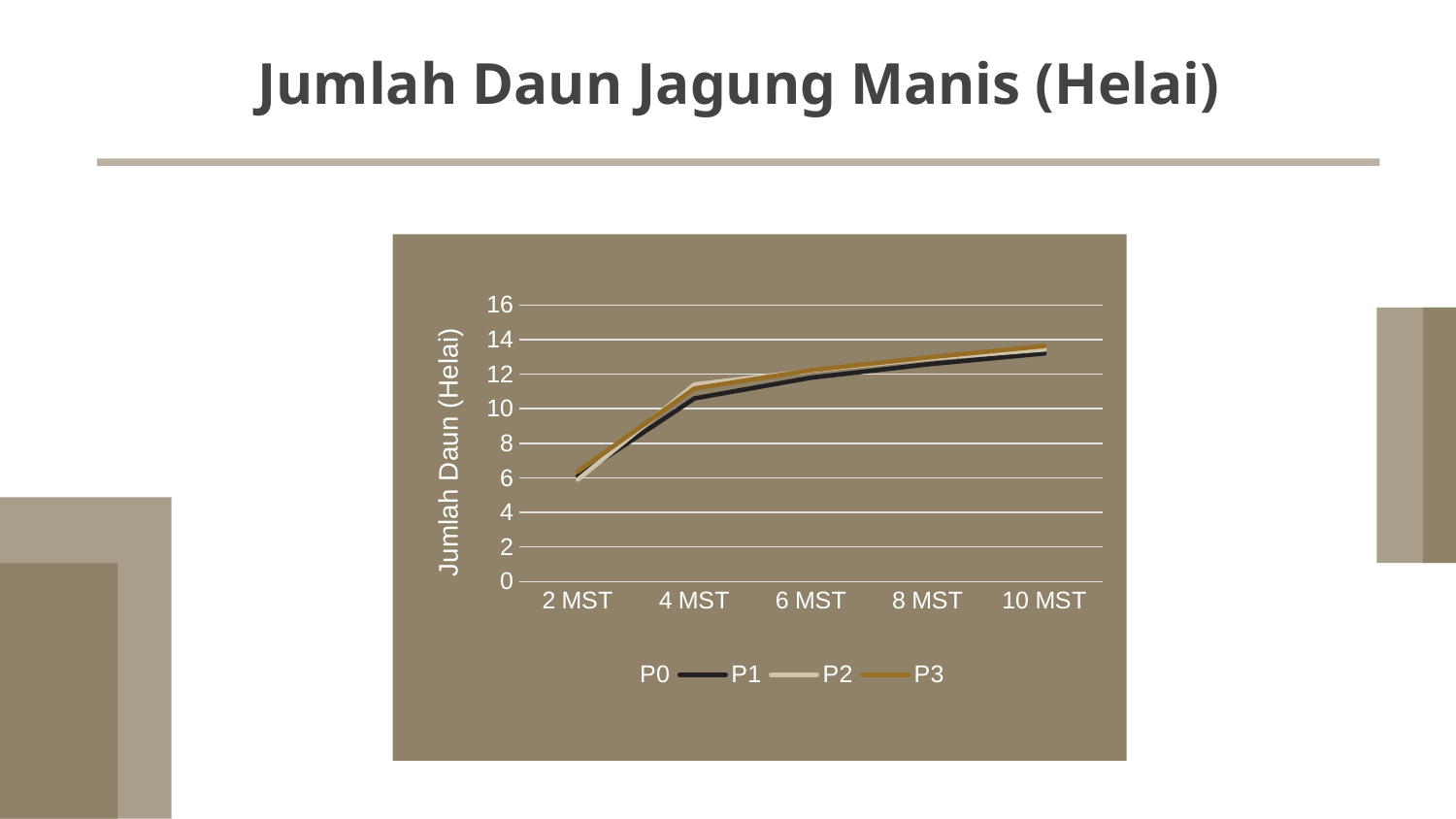
How many series does the chart legend list? 4 Which x-axis category has the highest values in the chart? 10 MST Are the values at 4 MST greater or less than 8? greater What is the title of the chart on the slide? Jumlah Daun Jagung Manis (Helai) Which x-axis category has the lowest values in the chart? 2 MST Do the values in the chart rise or fall from 2 MST to 10 MST? rise What kind of chart is shown on the slide? line chart Are the values at 10 MST greater or less than 12? greater How many categories are shown along the x axis of the chart? 5 Are the values at 8 MST greater or less than 10? greater What is the label of the vertical axis of the chart? Jumlah Daun (Helai)